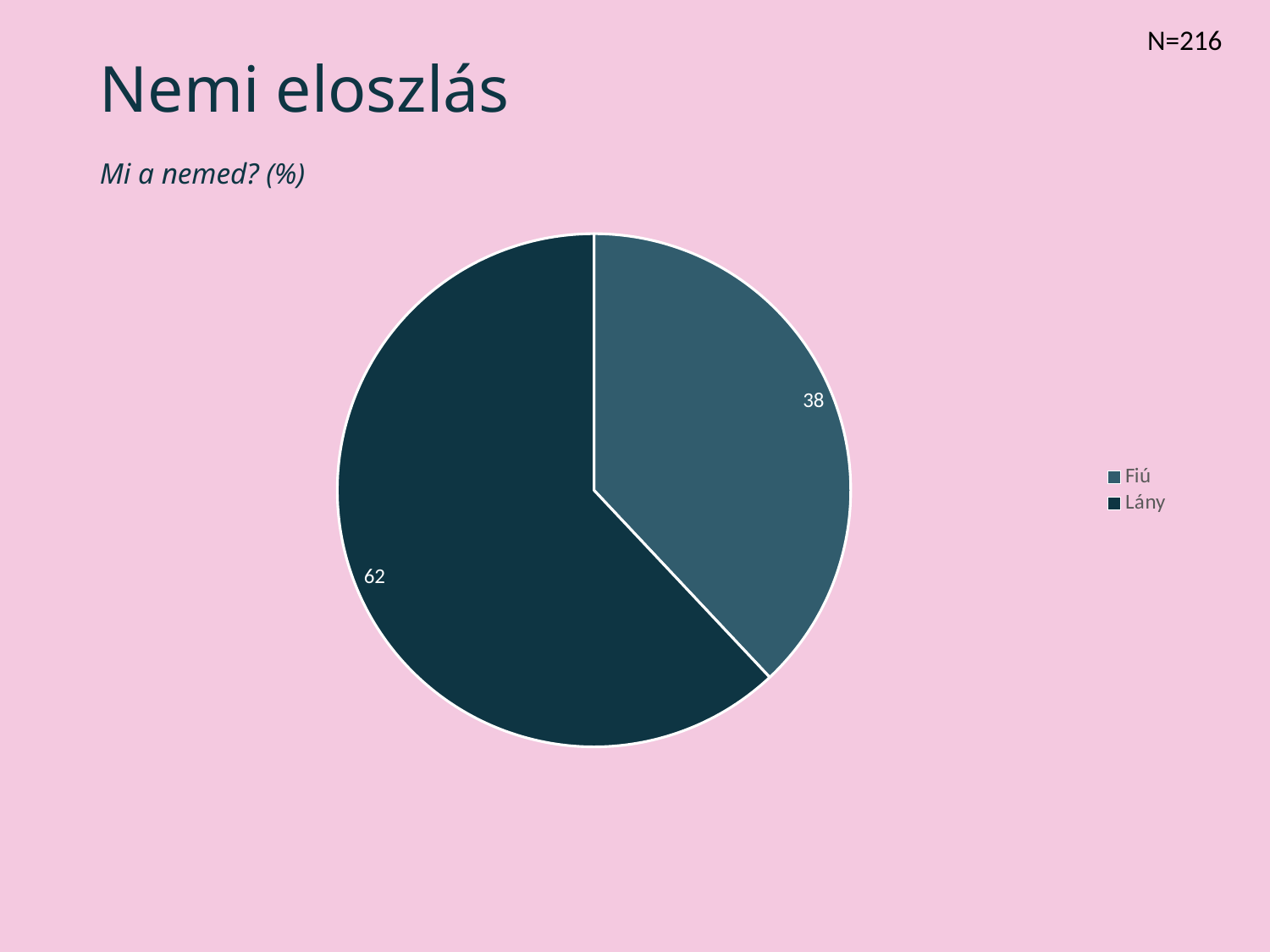
What kind of chart is shown on the slide? pie chart Which category has the largest slice of the pie? Lány Which is larger, the value for Fiú or the value for Lány? Lány What sample size (N) is shown on the slide? N=216 How many entries does the legend list? 2 What share of the pie does the Fiú slice represent? 38% What is the difference between the values for Lány and Fiú? 24 What is the value shown for Lány? 62 How many slices does the pie chart have? 2 What is the title of the slide containing the chart? Nemi eloszlás What is the value shown for Fiú? 38 Which category has the smallest slice of the pie? Fiú